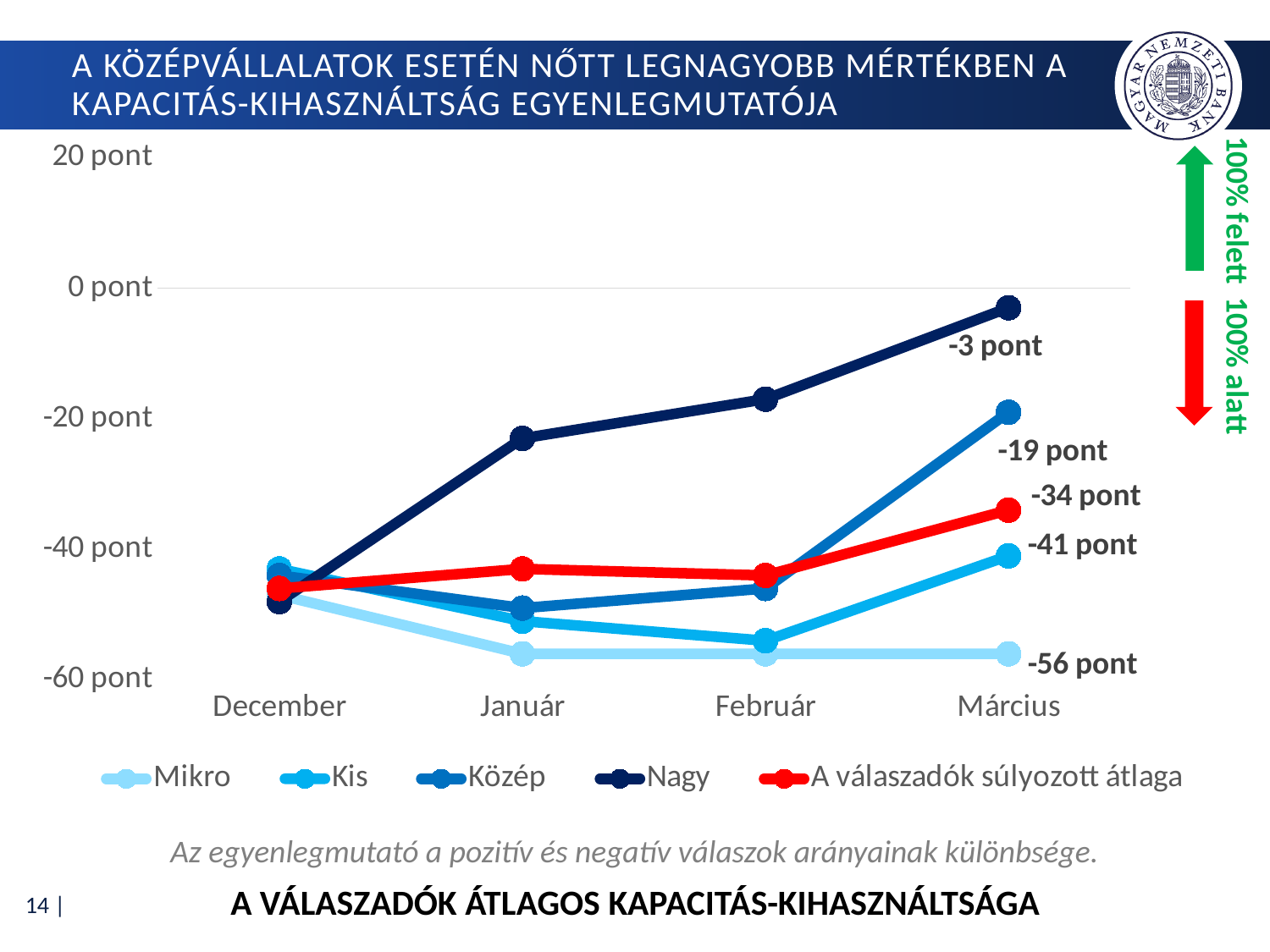
What is the value for Közép in Március? -19 pont Is the value for Nagy in Január greater or less than -20 pont? less Which series has the lowest value in Március? Mikro What kind of chart is shown on the slide? line chart What is the value for Mikro in Március? -56 pont Which series has the highest value in Március? Nagy What is the value for Nagy in Március? -3 pont How many series does the legend list? 5 How many months are shown on the x axis? 4 What is the difference between the Március values of Nagy and Mikro? 53 pont Does the Nagy series rise or fall from December to Március? rise What is the value for A válaszadók súlyozott átlaga in Március? -34 pont